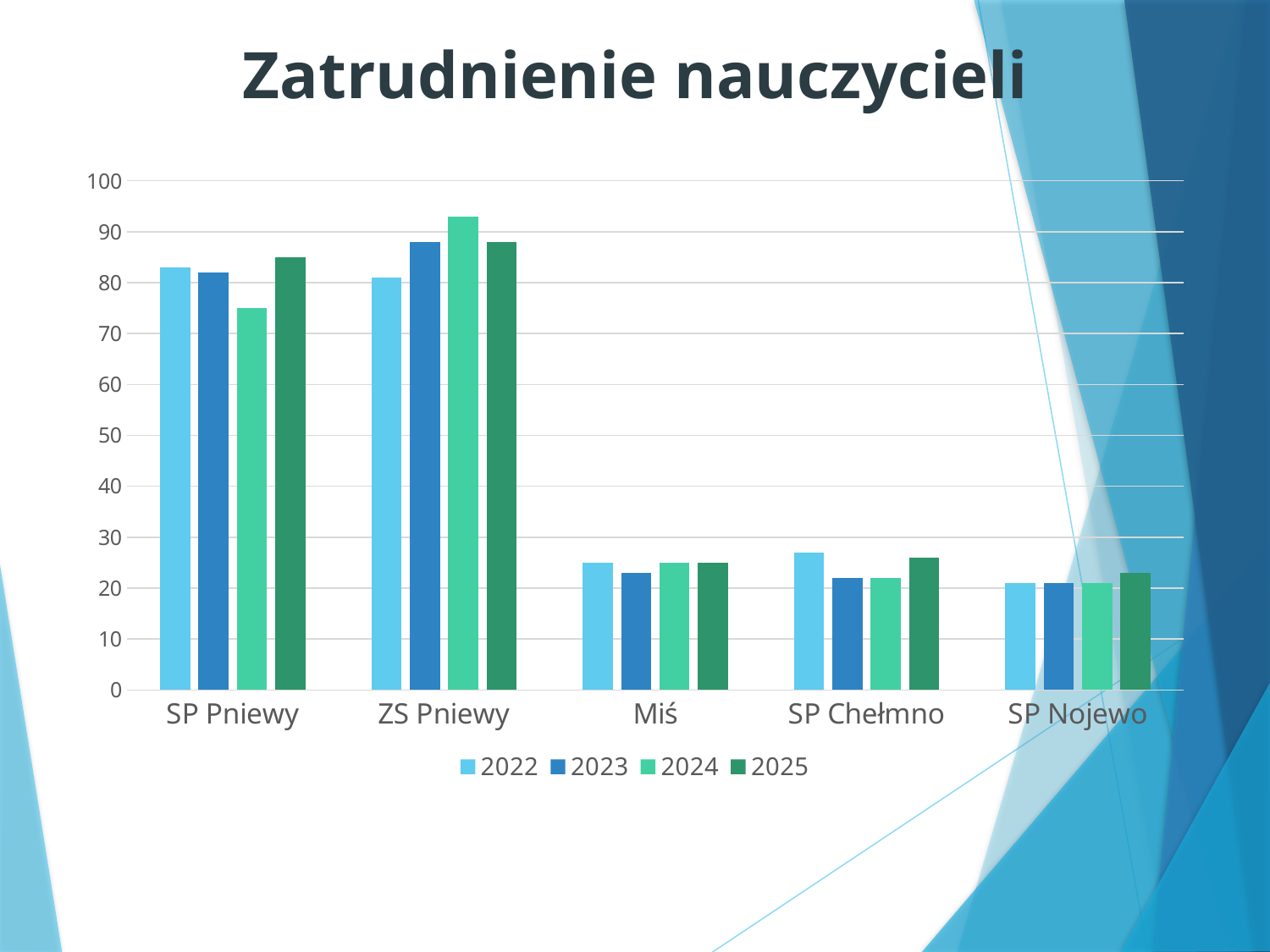
Is the value for Miś in 2022 greater or less than 30? less How many categories are shown on the x axis? 5 Which category has the lowest value for 2022? SP Nojewo Do the values for ZS Pniewy rise or fall from 2022 to 2024? rise What is the title of the chart? Zatrudnienie nauczycieli Which years are listed in the legend? 2022, 2023, 2024, 2025 Is the value for SP Pniewy in 2024 greater or less than 70? greater Which is larger for SP Pniewy: the 2024 value or the 2025 value? 2025 Is the value for ZS Pniewy in 2024 greater or less than 90? greater What kind of chart is shown on the slide? bar chart Which category has the highest value for 2024? ZS Pniewy How many series does the legend list? 4